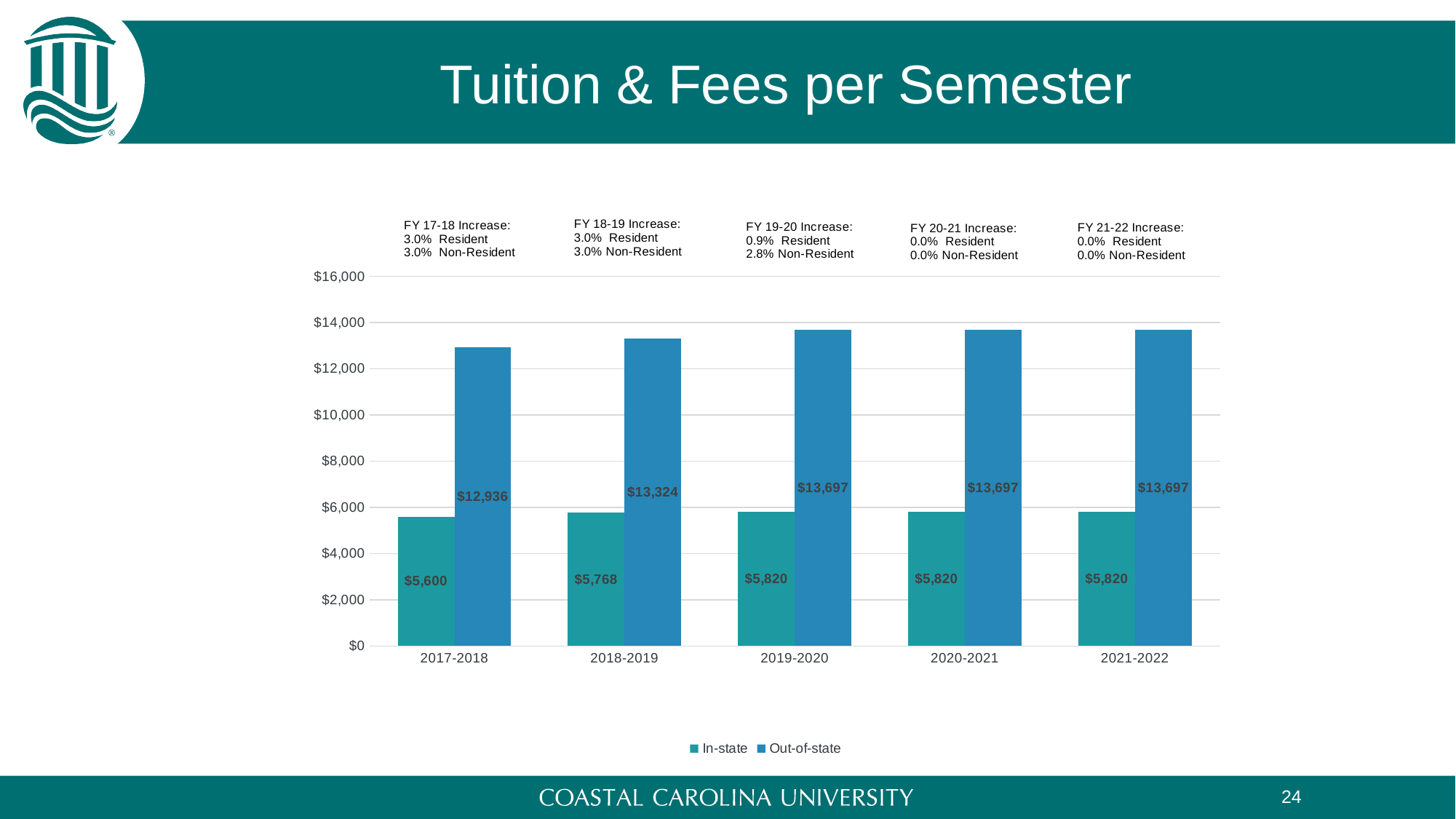
What is the Out-of-state value for 2021-2022? $13,697 How many academic years are shown on the x axis? 5 What is the difference between the Out-of-state values for 2018-2019 and 2017-2018? $388 Is the Out-of-state value for 2017-2018 greater or less than $14,000? less What is the In-state tuition and fees per semester for 2017-2018? $5,600 What is the difference between the Out-of-state and In-state values for 2019-2020? $7,877 What kind of chart is shown on the slide? Bar chart Which is larger, the In-state value for 2018-2019 or the In-state value for 2017-2018? 2018-2019 How many series does the legend list? 2 Which year has the lowest Out-of-state value? 2017-2018 Which year has the lowest In-state value? 2017-2018 What is the Out-of-state tuition and fees per semester for 2018-2019? $13,324